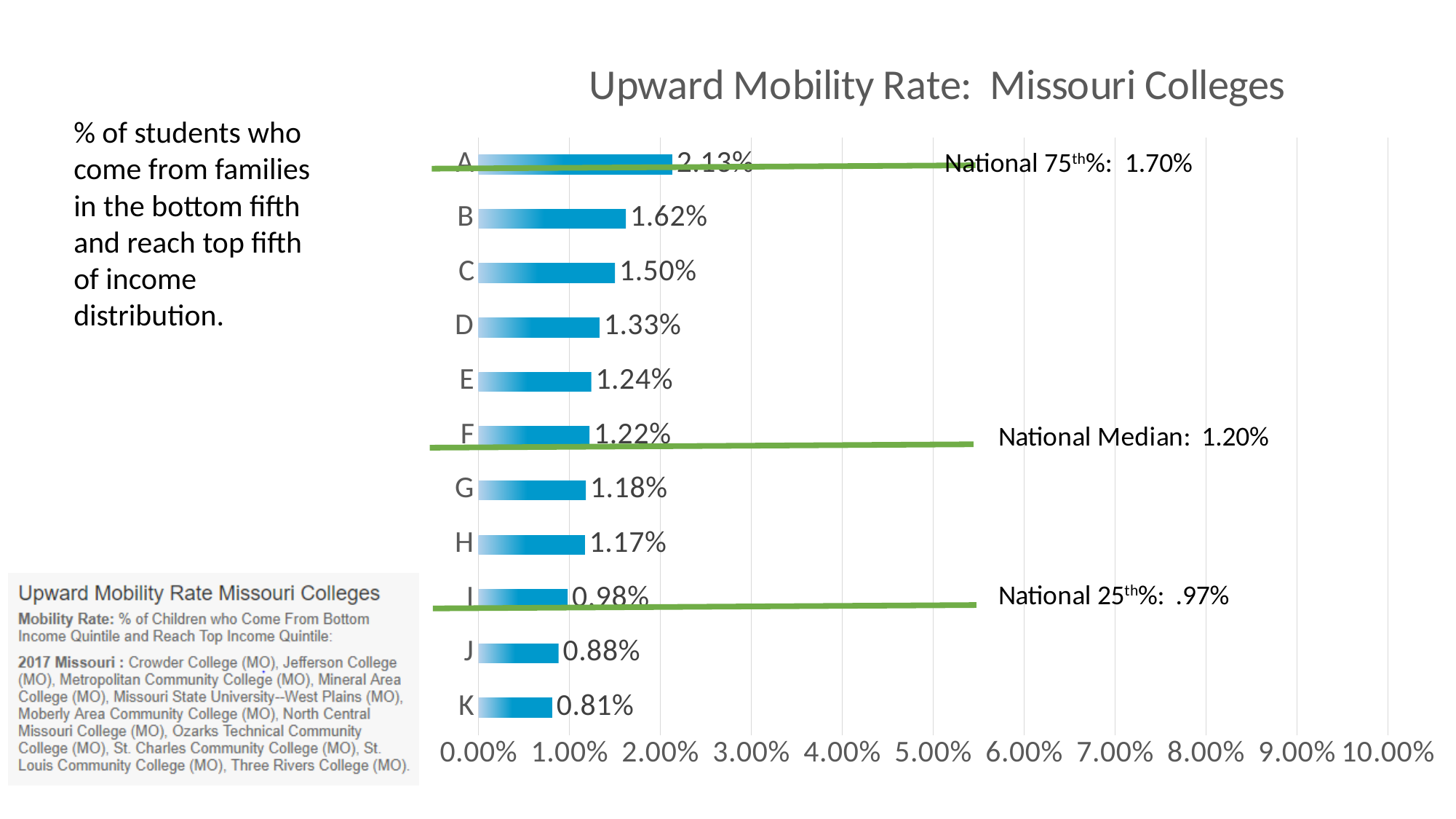
How many colleges (categories) are plotted in the chart? 11 What is the difference between the upward mobility rates of college B and college C? 0.12% Is the value for college A greater or less than 2.00%? greater What is the upward mobility rate for college D? 1.33% Which college has the lowest upward mobility rate? K What is the upward mobility rate for college B? 1.62% What type of chart is shown on the slide? bar chart Which has a higher upward mobility rate, college E or college G? E Which college has the highest upward mobility rate? A What is the title of the chart? Upward Mobility Rate: Missouri Colleges What value is given for the National Median line on the chart? 1.20% What is the upward mobility rate for college K? 0.81%